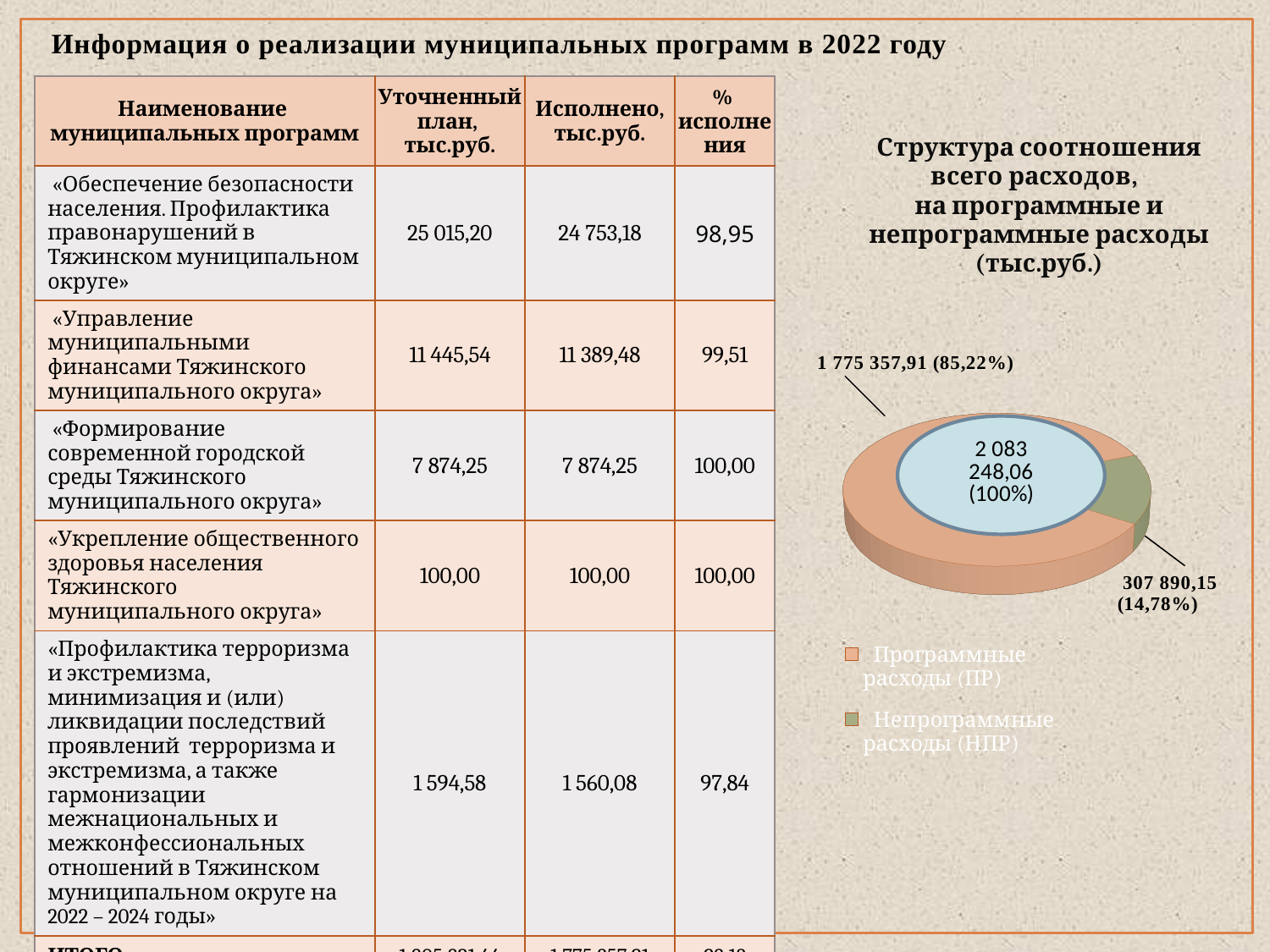
What kind of chart is shown on the right side of the slide? Pie chart How many slices does the pie chart have? 2 In the pie chart, what is the value shown for Непрограммные расходы (НПР)? 307 890,15 Which slice of the pie chart is the largest? Программные расходы (ПР) In the pie chart, what share of the total do Непрограммные расходы (НПР) make up? 14,78% In the pie chart, what is the value shown for Программные расходы (ПР)? 1 775 357,91 How many entries does the legend of the pie chart list? 2 In the pie chart, which is larger: Программные расходы (ПР) or Непрограммные расходы (НПР)? Программные расходы (ПР) What total value is printed in the centre of the pie chart? 2 083 248,06 (100%) In the pie chart, what share of the total do Программные расходы (ПР) make up? 85,22% Which slice of the pie chart is the smallest? Непрограммные расходы (НПР) What unit is stated in the title of the pie chart? тыс.руб.